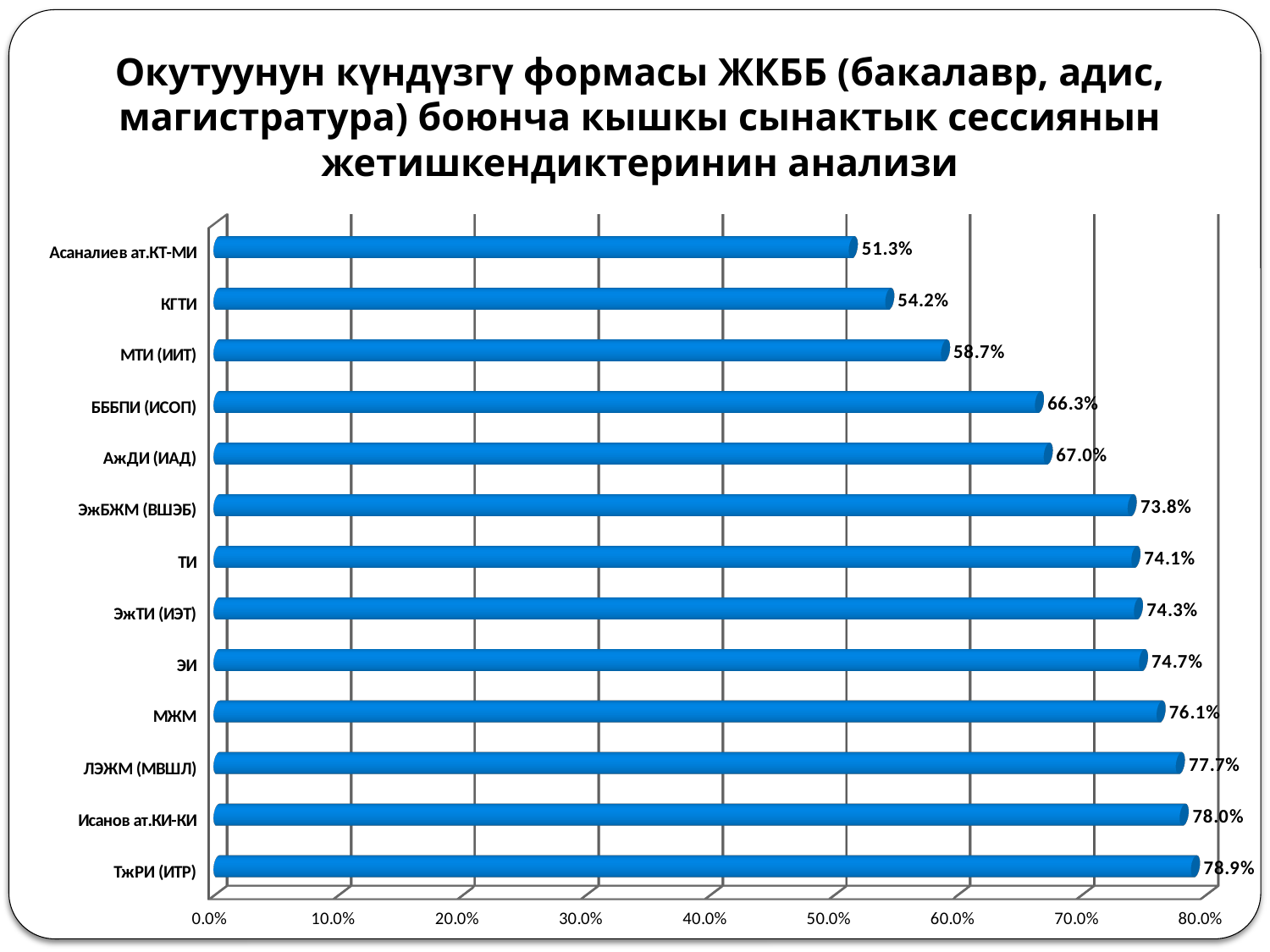
What is the highest value shown on the x axis? 80.0% Which category has the lowest value? Асаналиев ат.КТ-МИ What is the value for КГТИ? 54.2% Which is larger, the value for МТИ (ИИТ) or the value for БББПИ (ИСОП)? БББПИ (ИСОП) Which category has the highest value? ТжРИ (ИТР) What is the value for АжДИ (ИАД)? 67.0% Is the value for МЖМ greater or less than 70.0%? greater What is the difference between the values for ЛЭЖМ (МВШЛ) and Исанов ат.КИ-КИ? 0.3% What is the difference between the values for ТжРИ (ИТР) and Асаналиев ат.КТ-МИ? 27.6% What is the value for ТжРИ (ИТР)? 78.9% How many categories are shown in the chart? 13 What kind of chart is shown on the slide? bar chart